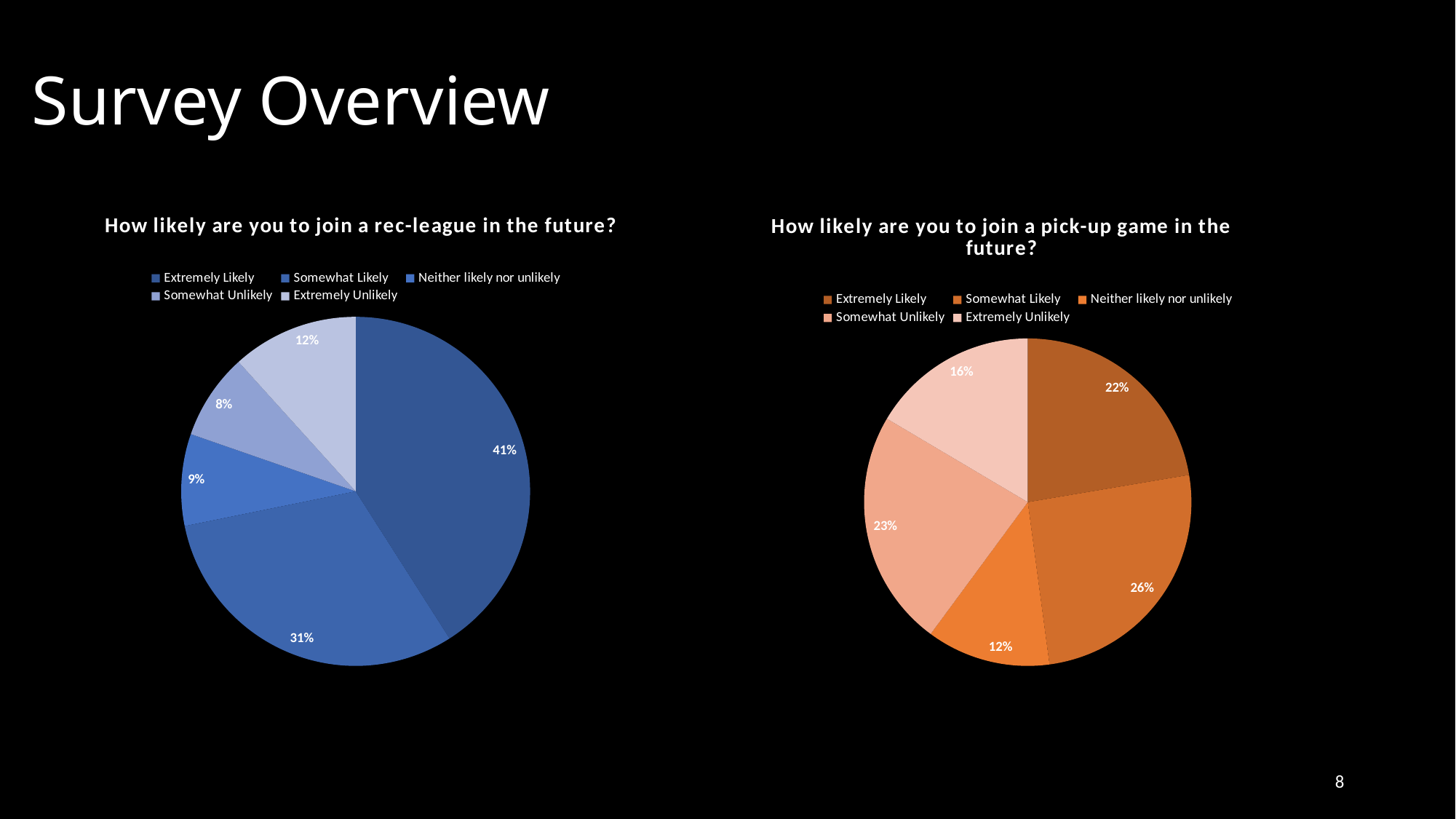
In the pick-up game chart, which response has the largest share? Somewhat Likely In the rec-league chart, which response has the smallest share? Somewhat Unlikely How many categories does the legend of the rec-league chart list? 5 What type of chart is used for the pick-up game question? Pie chart In the rec-league chart, what is the difference between the Extremely Likely and Somewhat Likely shares? 10% In the rec-league chart, which response has the largest share? Extremely Likely In the pick-up game chart, which is larger: the Extremely Likely share or the Somewhat Unlikely share? Somewhat Unlikely In the pick-up game chart, what share of respondents are Somewhat Unlikely to join? 23% In the rec-league chart, what share of respondents are Extremely Likely to join? 41% In the pick-up game chart, which response has the smallest share? Neither likely nor unlikely In the rec-league chart, what share of respondents are Somewhat Likely to join? 31% In the pick-up game chart, what share of respondents are Extremely Unlikely to join? 16%